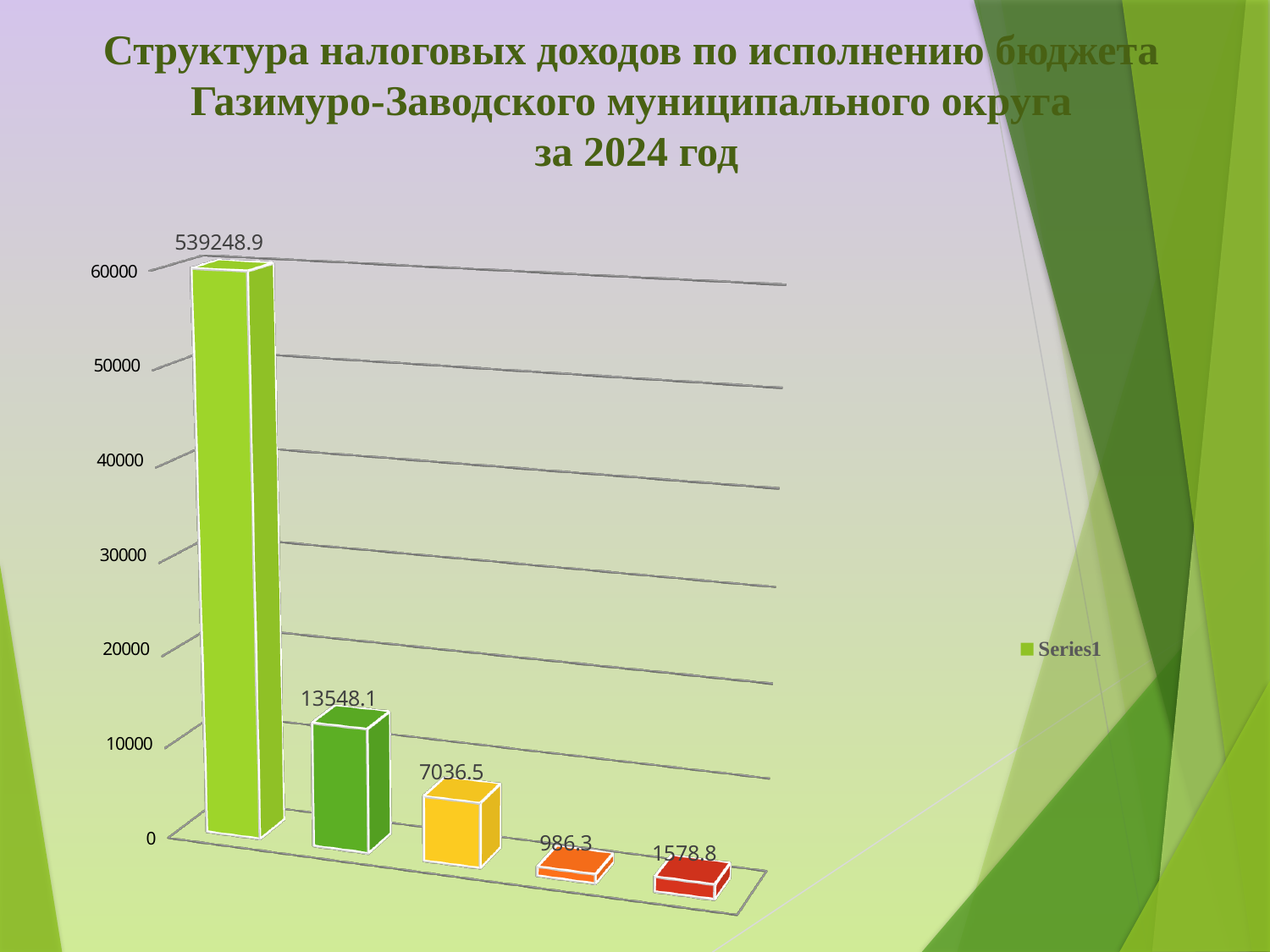
What is the data label on the fourth (orange) bar? 986.3 Which bar has the lowest value? the fourth (orange) bar, 986.3 Which is larger, the value of the fourth (orange) bar or the fifth (red) bar? the fifth (red) bar, 1578.8 What is the data label on the fifth (rightmost, red) bar? 1578.8 What type of chart is shown on the slide? bar chart What is the data label on the third (yellow) bar? 7036.5 How many bars are plotted in the chart? 5 What is the name of the series shown in the legend? Series1 What is the data label on the second (dark green) bar? 13548.1 What is the difference between the second bar (13548.1) and the third bar (7036.5)? 6511.6 What is the data label on the first (leftmost, light green) bar? 539248.9 How many series does the legend list? 1